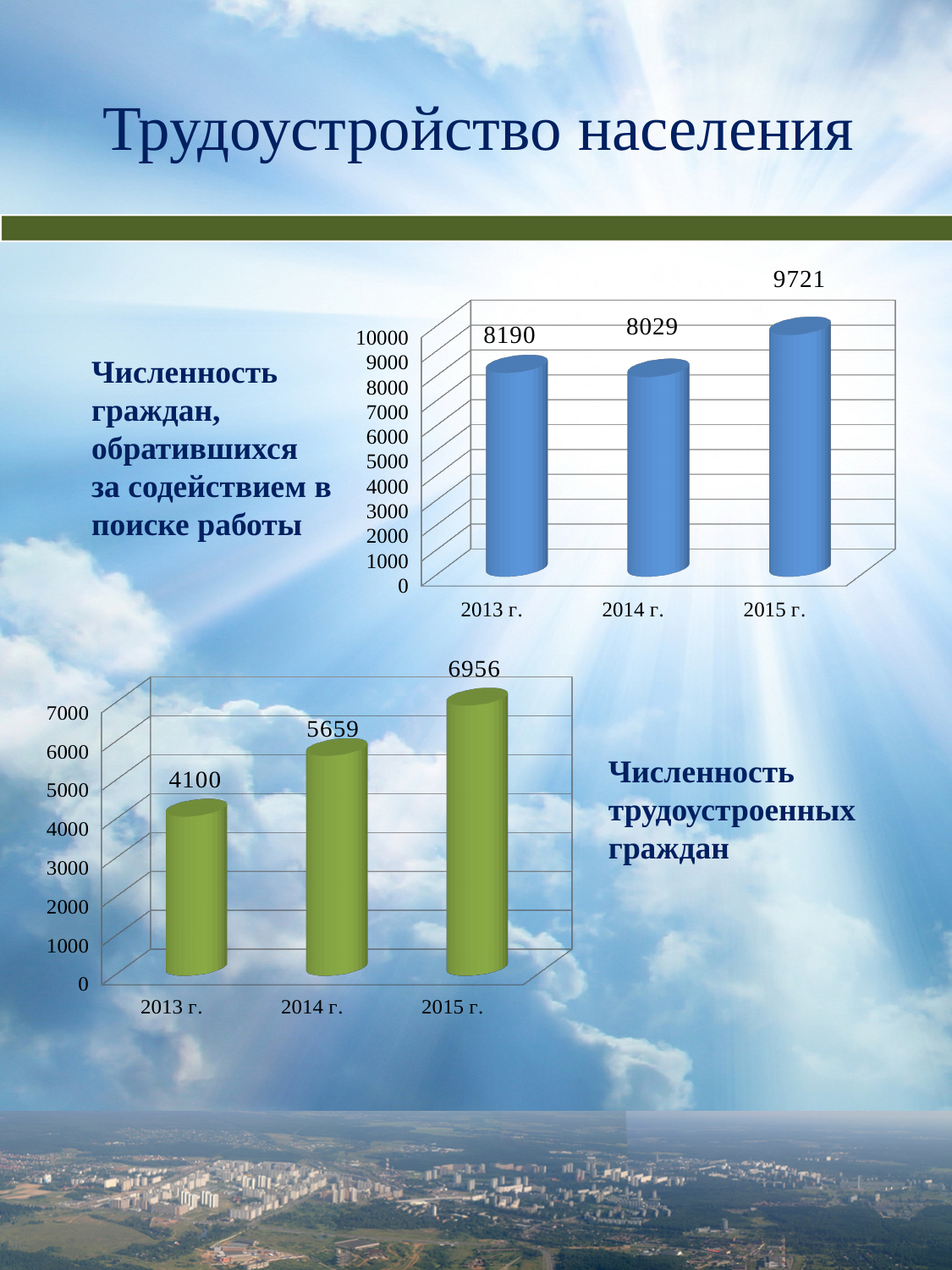
What kind of chart is the bottom chart (Численность трудоустроенных граждан)? bar chart In the top chart (Численность граждан, обратившихся за содействием в поиске работы), what is the value for 2014 г.? 8029 In the top chart (Численность граждан, обратившихся за содействием в поиске работы), which year has the lowest value? 2014 г. In the bottom chart (Численность трудоустроенных граждан), which year has the highest value? 2015 г. Which is larger: the value for 2013 г. in the top chart or the value for 2015 г. in the bottom chart? 2013 г. in the top chart In the bottom chart (Численность трудоустроенных граждан), what is the value for 2013 г.? 4100 In the bottom chart (Численность трудоустроенных граждан), what is the difference between the values for 2015 г. and 2014 г.? 1297 In the top chart (Численность граждан, обратившихся за содействием в поиске работы), how many years are shown? 3 In the bottom chart (Численность трудоустроенных граждан), do the values rise or fall from 2013 г. to 2015 г.? rise In the bottom chart (Численность трудоустроенных граждан), what is the value for 2014 г.? 5659 In the top chart (Численность граждан, обратившихся за содействием в поиске работы), what is the value for 2015 г.? 9721 In the top chart (Численность граждан, обратившихся за содействием в поиске работы), what is the difference between the values for 2015 г. and 2013 г.? 1531